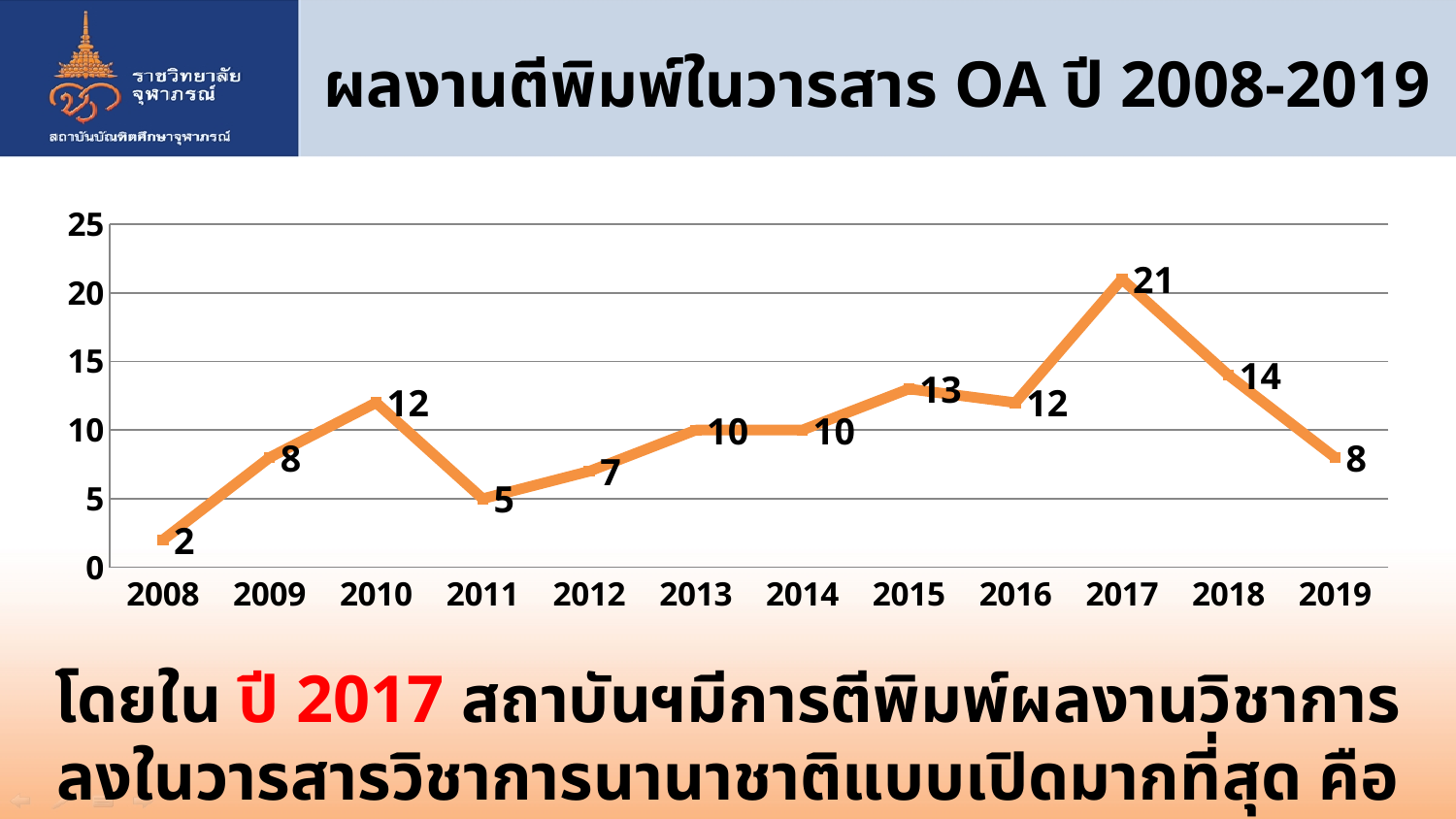
Do the values rise or fall from 2011 to 2015? rise What is the value for 2008? 2 What is the value for 2017? 21 What is the difference between the values for 2010 and 2011? 7 Is the value for 2018 greater or less than 10? greater Which year has the lowest value? 2008 What is the value for 2011? 5 How many years are plotted on the chart? 12 What kind of chart is shown on the slide? line chart Which is larger, the value for 2015 or the value for 2016? 2015 Which year has the highest value? 2017 What is the difference between the values for 2017 and 2018? 7